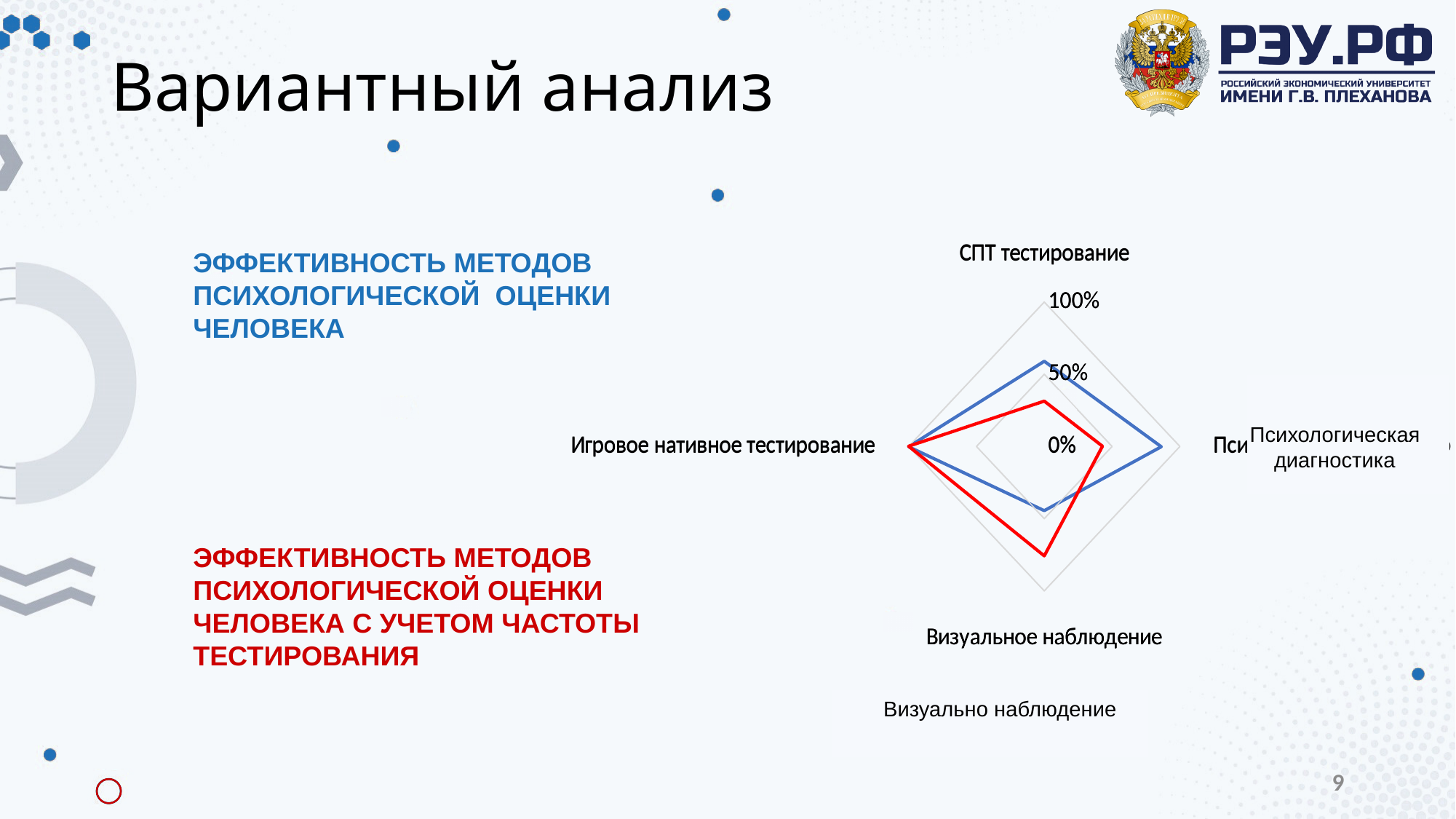
How many categories (axes) does the radar chart have? 4 Is the red series value for Психологическая диагностика greater or less than 50%? less For Визуальное наблюдение, which series has the larger value, the blue or the red one? red What is the highest percentage tick shown on the radar chart's axis? 100% How many data series (lines) are plotted on the radar chart? 2 Is the red series value for Визуальное наблюдение greater or less than 50%? greater Is the blue series value for Визуальное наблюдение greater or less than 50%? less For Психологическая диагностика, which series has the larger value, the blue or the red one? blue Which category has the highest value in the red series? Игровое нативное тестирование What kind of chart is shown on the slide? radar chart